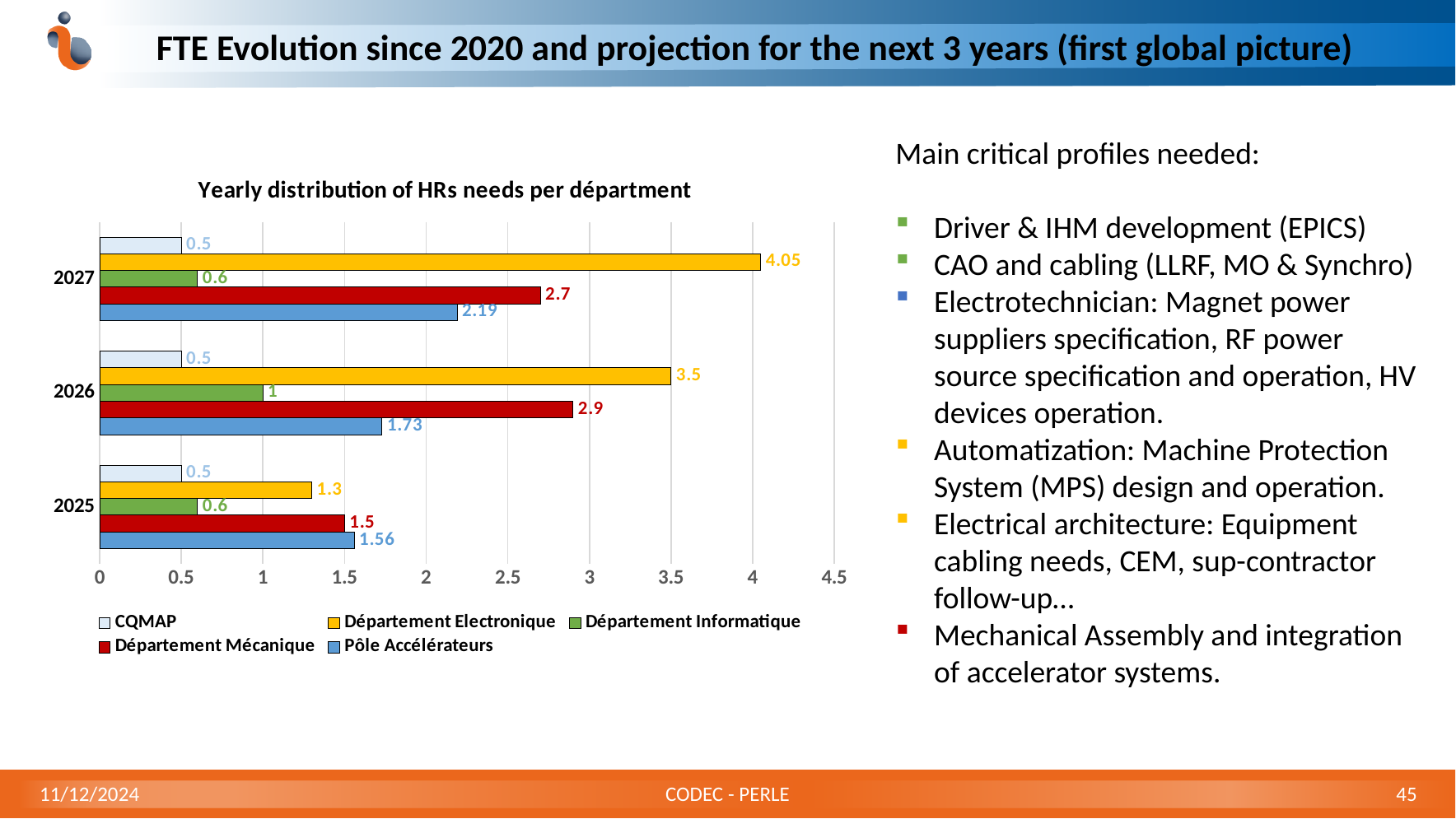
Which department has the lowest value in 2026? CQMAP What is the value for Département Mécanique in 2025? 1.5 Does the value for Département Electronique rise or fall from 2025 to 2027? Rise Which is larger in 2026: Département Mécanique or Pôle Accélérateurs? Département Mécanique How many years are shown on the y axis? 3 Which department has the highest value in 2027? Département Electronique What is the value for Département Electronique in 2027? 4.05 What is the title of the chart? Yearly distribution of HRs needs per départment What kind of chart is shown? Bar chart What is the difference between the Département Electronique values for 2027 and 2025? 2.75 How many series does the legend list? 5 What is the value for Pôle Accélérateurs in 2026? 1.73